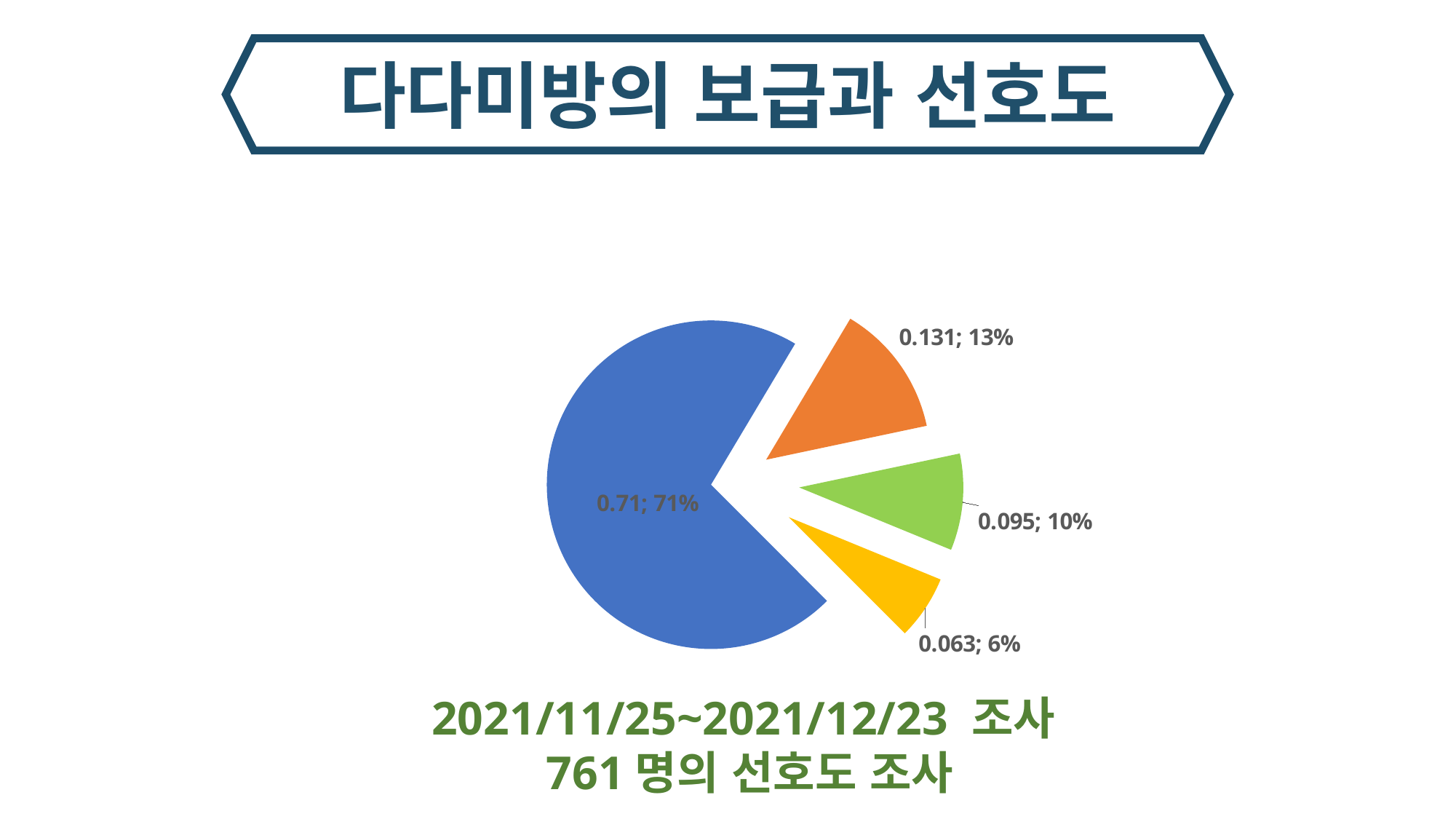
How many slices does the pie chart have? 4 What percentage is shown on the blue slice of the pie chart? 71% What percentage is shown on the green slice of the pie chart? 10% How many people were surveyed according to the text below the pie chart? 761 Which slice of the pie chart is the largest? the blue slice (71%) Which slice of the pie chart is the smallest? the yellow slice (6%) Which is larger in the pie chart, the orange slice or the green slice? the orange slice What kind of chart is shown on the slide? pie chart What value is printed on the yellow slice of the pie chart? 0.063; 6% What is the difference in percentage points between the blue slice (71%) and the orange slice (13%)? 58 percentage points What share of the pie does the green slice represent? 10% What value is printed on the orange slice of the pie chart? 0.131; 13%